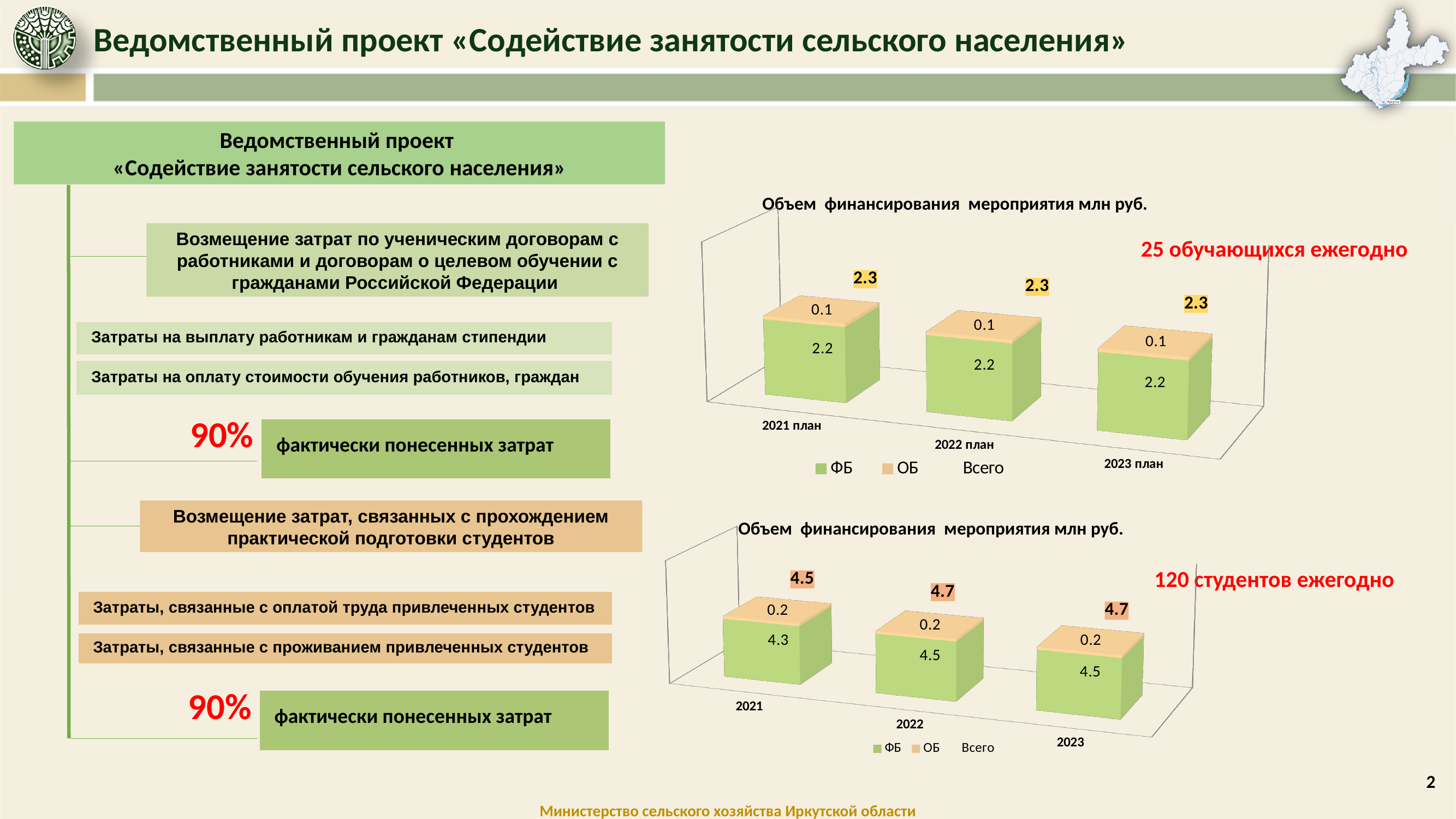
In the bottom chart, what is the difference between the ФБ values for 2022 and 2021? 0.2 How many series does the legend of the bottom chart list? 3 In the top chart, what is the Всего value for 2022 план? 2.3 In the bottom chart, what is the Всего value for 2023? 4.7 How many categories are shown on the x axis of the top chart? 3 In the bottom chart, which is larger: the ФБ value for 2021 or the ФБ value for 2022? 2022 In the bottom chart, what is the ФБ value for 2021? 4.3 In the bottom chart, what is the ОБ value for 2022? 0.2 In the top chart, what is the ФБ value for 2021 план? 2.2 What is the title of the bottom chart? Объем финансирования мероприятия млн руб. In the top chart, what is the ОБ value for 2023 план? 0.1 What kind of chart is the top chart? bar chart